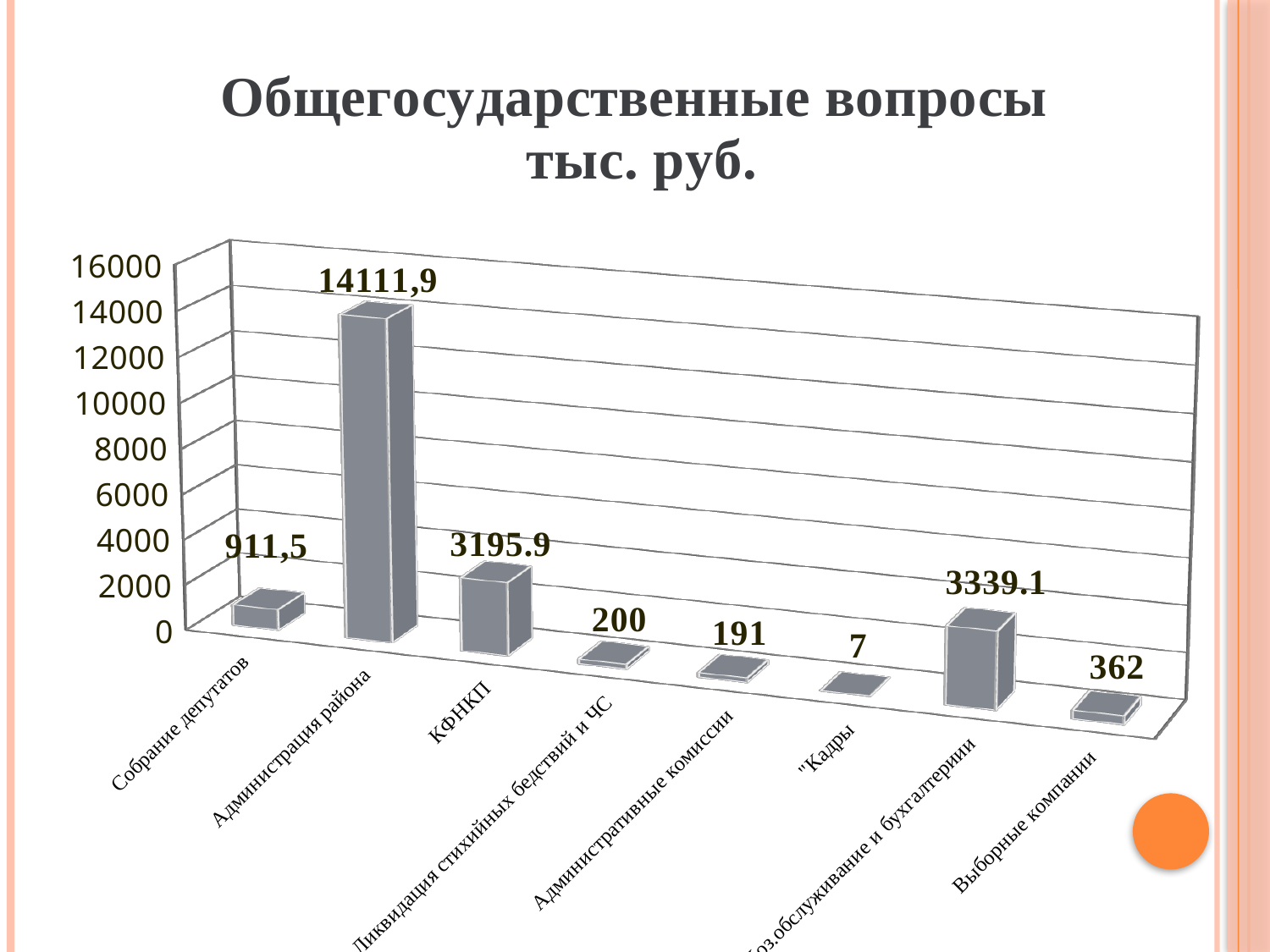
What is the value for Администрация района? 14111,9 What is the value for КФНКП? 3195.9 Is the value for Администрация района greater or less than 12000? greater How many categories are shown on the x axis? 8 What is the value for Собрание депутатов? 911,5 Which category has the lowest value? "Кадры What is the difference between the values for Собрание депутатов and Выборные компании? 549,5 What is the difference between the values for Ликвидация стихийных бедствий и ЧС and Административные комиссии? 9 What is the value for Выборные компании? 362 What kind of chart is shown on the slide? bar chart Which category has the highest value? Администрация района Which is larger, the value for КФНКП or the value for Собрание депутатов? КФНКП